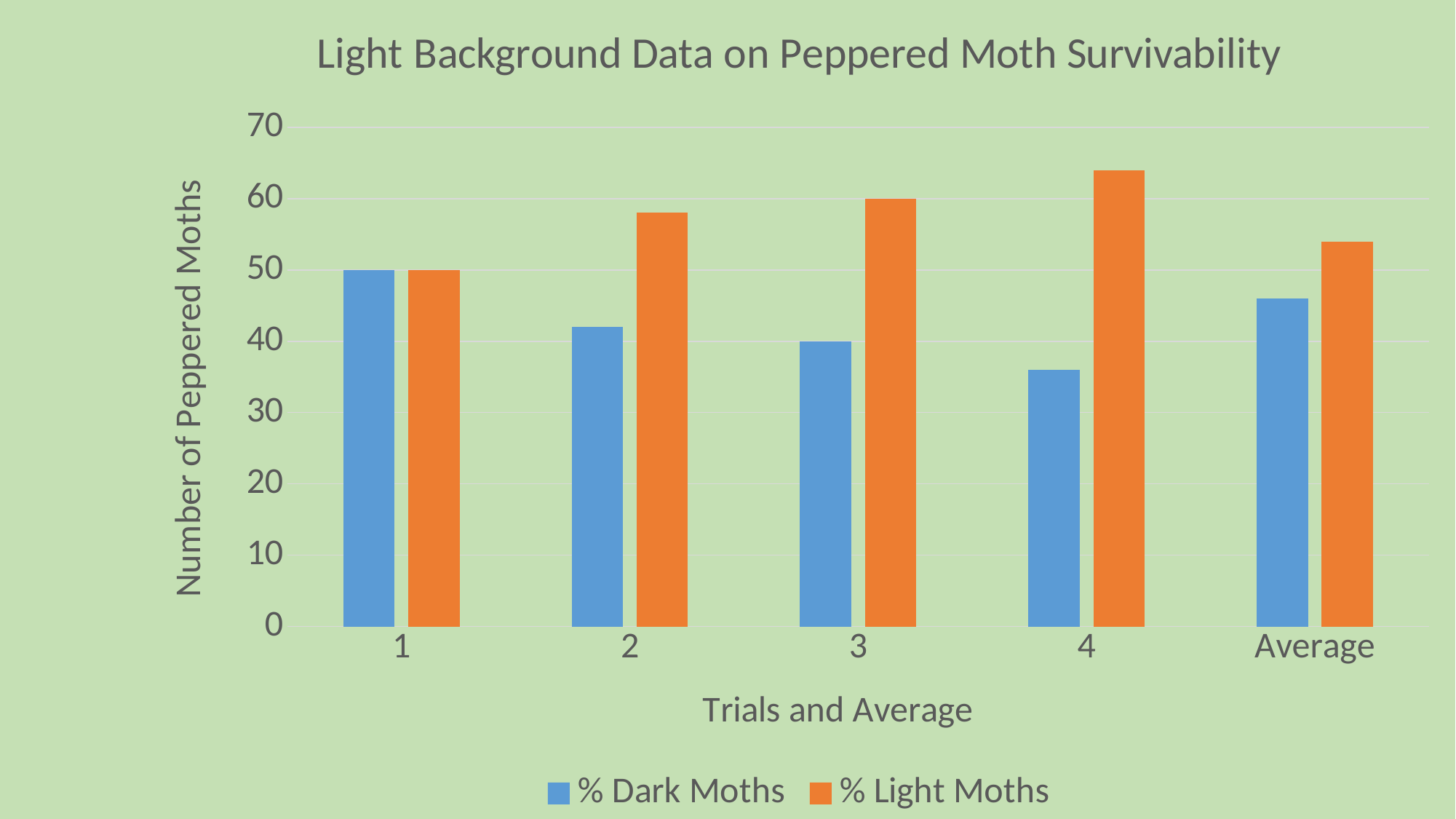
Is the value for % Dark Moths in trial 4 greater or less than 40? less Which trial has the lowest value for % Dark Moths? 4 What is the value for % Light Moths in trial 3? 60 Is the value for % Light Moths in trial 4 greater or less than 60? greater What is the value for % Dark Moths in trial 1? 50 What is the value for % Dark Moths in trial 3? 40 What type of chart is shown on the slide? bar chart What is the title of the chart? Light Background Data on Peppered Moth Survivability Do the % Dark Moths values rise or fall from trial 1 to trial 4? fall How many categories are shown on the x axis? 5 Which trial has the highest value for % Light Moths? 4 How many series does the legend list? 2